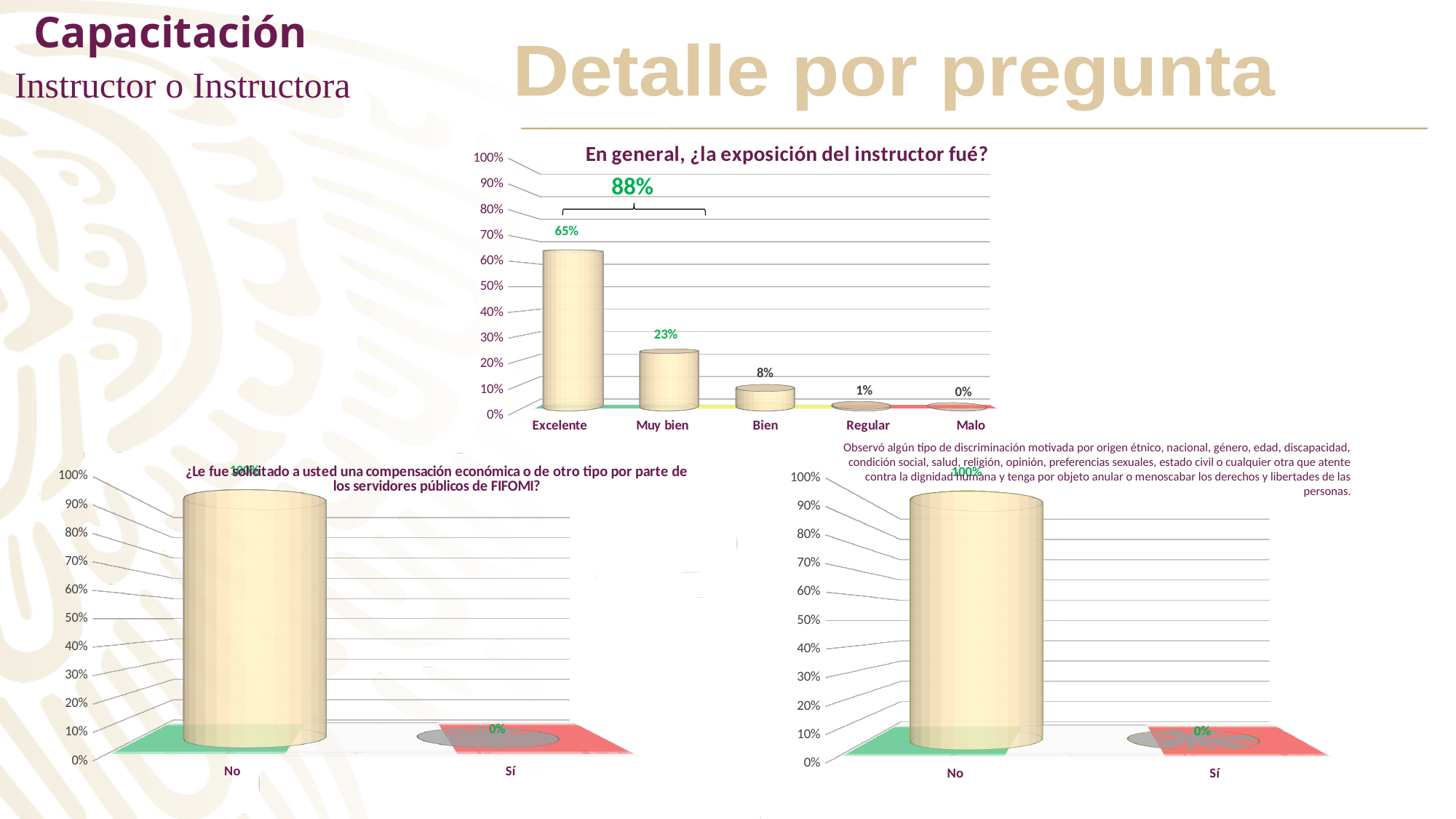
In the top chart titled "En general, ¿la exposición del instructor fué?", what combined percentage is shown by the bracket above Excelente and Muy bien? 88% In the bottom-left chart about compensación económica from FIFOMI servidores públicos, what is the value for No? 100% In the top chart titled "En general, ¿la exposición del instructor fué?", do the values rise or fall from Excelente to Malo? fall In the top chart titled "En general, ¿la exposición del instructor fué?", what is the value for Bien? 8% In the top chart titled "En general, ¿la exposición del instructor fué?", how many categories are shown on the x axis? 5 In the top chart titled "En general, ¿la exposición del instructor fué?", which category has the lowest value? Malo In the top chart titled "En general, ¿la exposición del instructor fué?", what is the value for Excelente? 65% In the bottom-right chart about discriminación, what is the value for Sí? 0% In the top chart titled "En general, ¿la exposición del instructor fué?", which category has the highest value? Excelente What kind of chart is the bottom-left chart about compensación económica? bar chart In the top chart titled "En general, ¿la exposición del instructor fué?", what is the value for Muy bien? 23% In the top chart titled "En general, ¿la exposición del instructor fué?", what is the difference between the values for Excelente and Muy bien? 42%